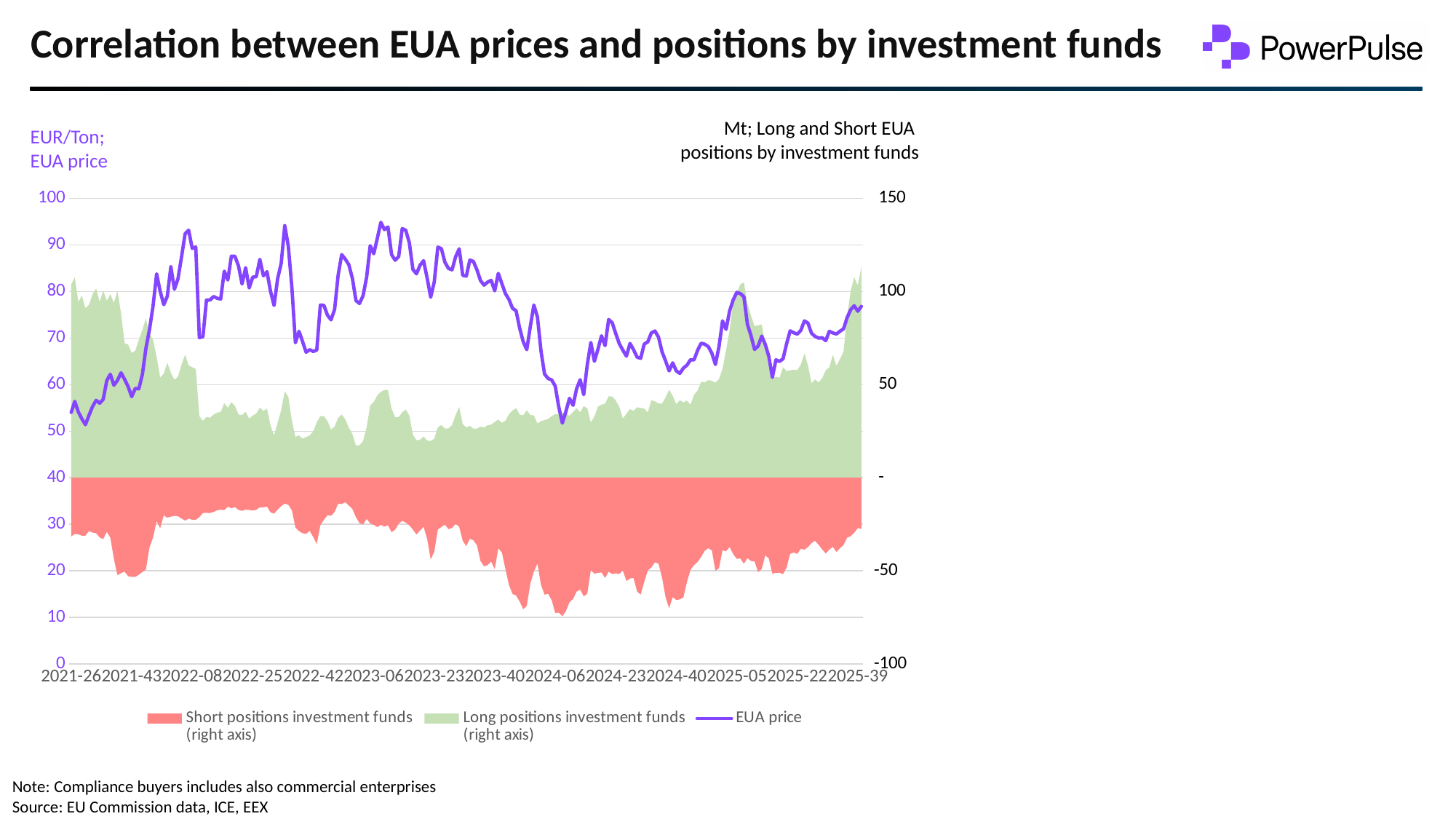
What kind of chart is shown on the slide? area and line chart How many series does the legend list? 3 Is the EUA price at 2024-06 greater or less than 70? less Is the value for short positions investment funds at 2024-06 greater or less than -50 on the right axis? less Is the EUA price at 2025-39 greater or less than 70? greater Which series is plotted as a purple line? EUA price What is the title of the chart? Correlation between EUA prices and positions by investment funds How many labels are shown on the x axis? 14 Does the long positions investment funds area rise or fall between 2024-06 and 2025-39? rise Does the EUA price rise or fall between 2023-23 and 2024-06? fall